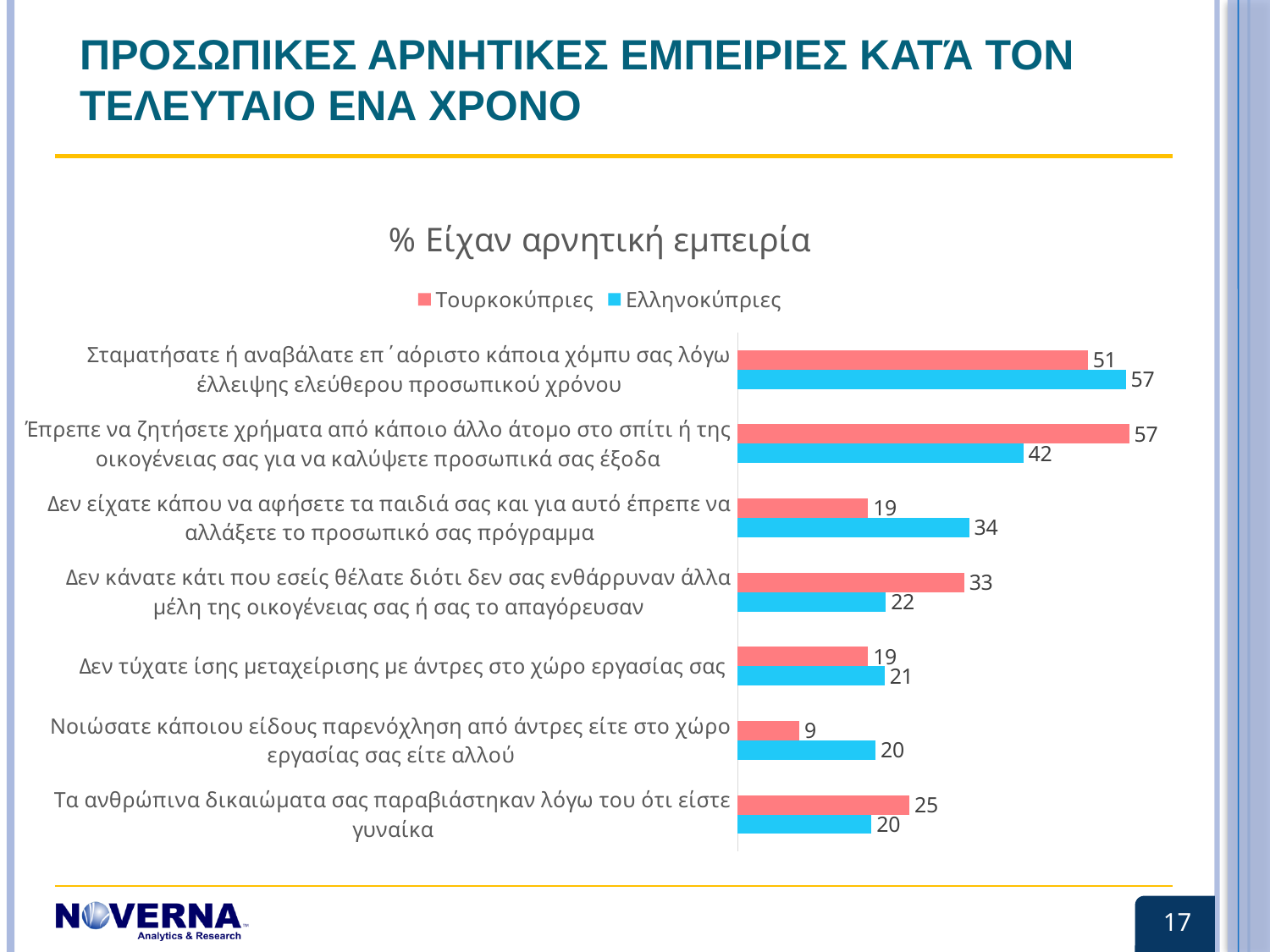
How many series does the legend list? 2 What is the difference between the Ελληνοκύπριες and Τουρκοκύπριες values for 'Δεν είχατε κάπου να αφήσετε τα παιδιά σας και για αυτό έπρεπε να αλλάξετε το προσωπικό σας πρόγραμμα'? 15 What is the value for Τουρκοκύπριες for 'Νοιώσατε κάποιου είδους παρενόχληση από άντρες είτε στο χώρο εργασίας σας είτε αλλού'? 9 What kind of chart is shown on the slide? Bar chart Which category has the highest value for Ελληνοκύπριες? Σταματήσατε ή αναβάλατε επ΄αόριστο κάποια χόμπυ σας λόγω έλλειψης ελεύθερου προσωπικού χρόνου How many categories are shown in the chart? 7 Which category has the lowest value for Τουρκοκύπριες? Νοιώσατε κάποιου είδους παρενόχληση από άντρες είτε στο χώρο εργασίας σας είτε αλλού What is the value for Ελληνοκύπριες for 'Σταματήσατε ή αναβάλατε επ΄αόριστο κάποια χόμπυ σας λόγω έλλειψης ελεύθερου προσωπικού χρόνου'? 57 What is the value for Τουρκοκύπριες for 'Έπρεπε να ζητήσετε χρήματα από κάποιο άλλο άτομο στο σπίτι ή της οικογένειας σας για να καλύψετε προσωπικά σας έξοδα'? 57 For 'Δεν κάνατε κάτι που εσείς θέλατε διότι δεν σας ενθάρρυναν άλλα μέλη της οικογένειας σας ή σας το απαγόρευσαν', which group has the larger value, Τουρκοκύπριες or Ελληνοκύπριες? Τουρκοκύπριες For 'Τα ανθρώπινα δικαιώματα σας παραβιάστηκαν λόγω του ότι είστε γυναίκα', which group has the larger value, Τουρκοκύπριες or Ελληνοκύπριες? Τουρκοκύπριες What is the title of the chart? % Είχαν αρνητική εμπειρία